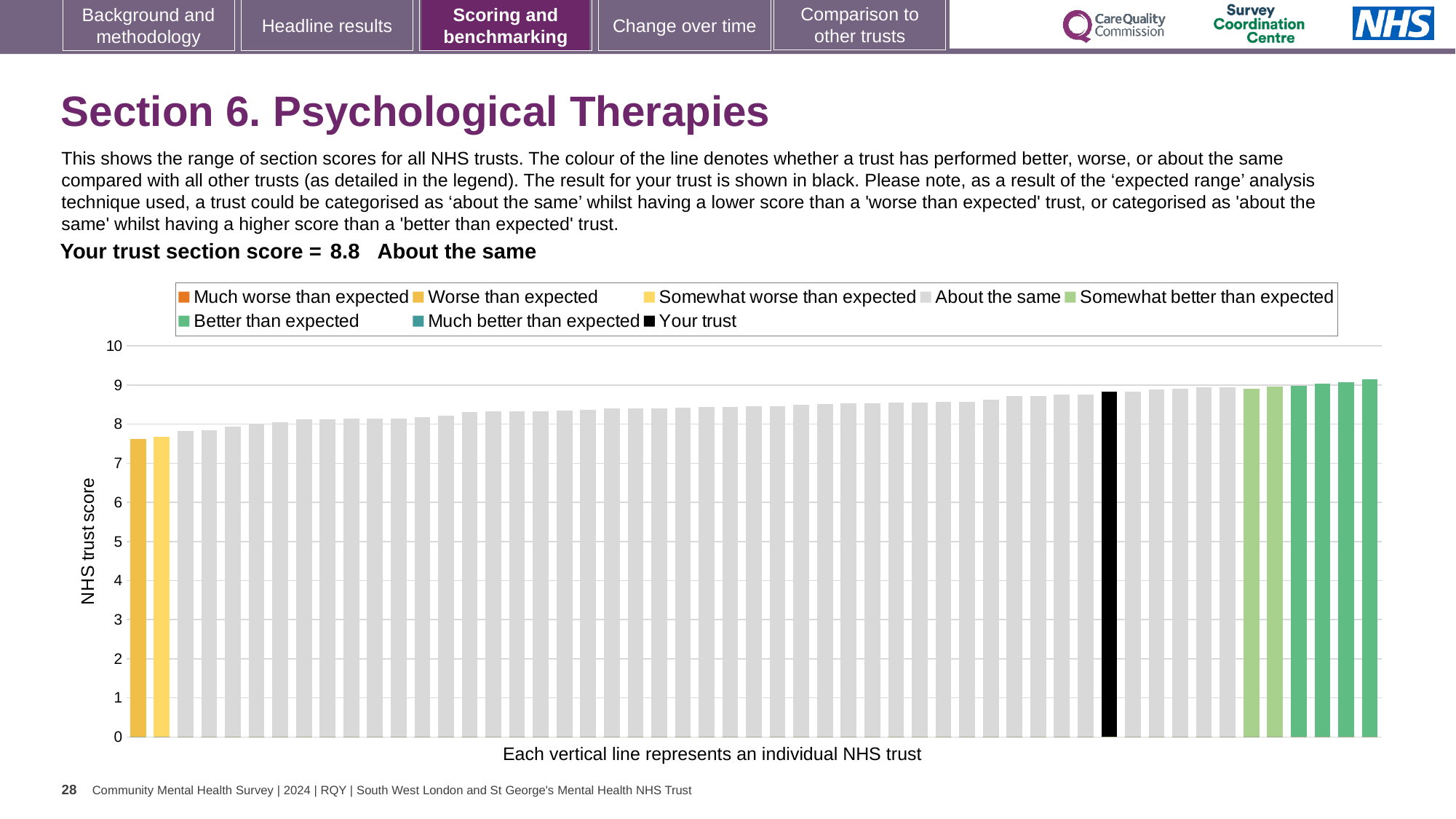
What kind of chart is shown on the slide? Bar chart Is the value of the black bar greater or less than 8? greater How many entries does the chart legend list? 8 What is the label on the vertical axis of the chart? NHS trust score How is your trust's section score categorised on the slide? About the same Is the value of the leftmost (lowest) bar greater or less than 8? less What colour is the bar representing your trust? Black Is the value of the rightmost (highest) bar greater or less than 8? greater How many bars on the chart are coloured black? 1 Do the bar values rise or fall from left to right along the x axis? Rise Which is larger: the black bar for your trust or the leftmost bar? The black bar for your trust What is the section score for your trust shown on the slide? 8.8